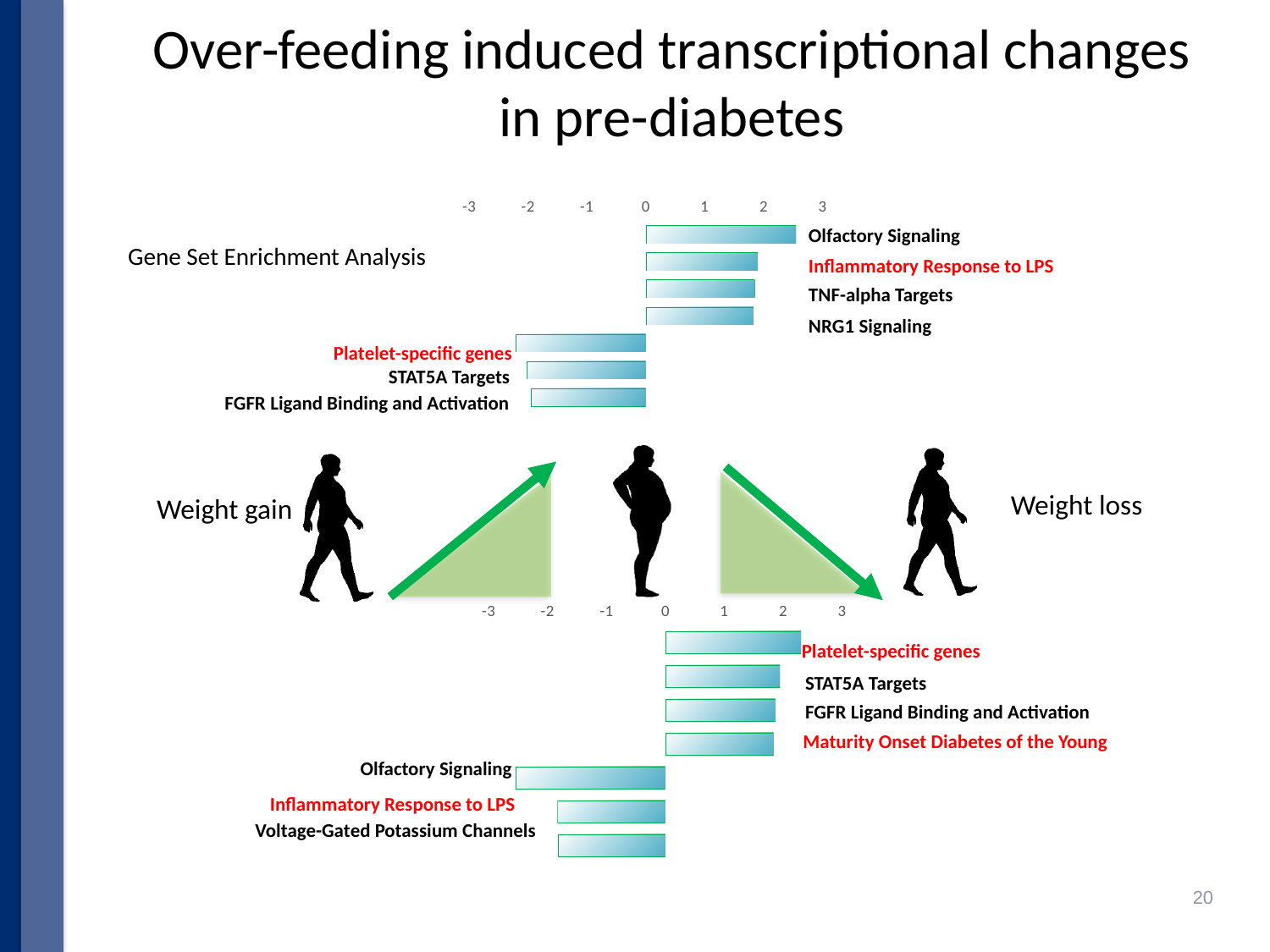
In the top chart (weight gain), which gene set has the highest positive value? Olfactory Signaling What kind of chart is the top chart under 'Gene Set Enrichment Analysis'? bar chart In the top chart (weight gain), is the value for Olfactory Signaling greater or less than 2? greater In the top chart (weight gain), is the value for TNF-alpha Targets greater or less than 2? less In the top chart (weight gain), how many gene sets are plotted? 7 In the top chart (weight gain), which is larger, the value for Olfactory Signaling or the value for NRG1 Signaling? Olfactory Signaling In the bottom chart (weight loss), which gene set has the highest positive value? Platelet-specific genes In the bottom chart (weight loss), which gene set has the lowest (most negative) value? Olfactory Signaling In the bottom chart (weight loss), is the value for Olfactory Signaling greater or less than -2? less In the bottom chart (weight loss), which is larger, the value for Platelet-specific genes or the value for Maturity Onset Diabetes of the Young? Platelet-specific genes In the bottom chart (weight loss), how many gene sets are plotted? 7 What is the title of the slide containing the two bar charts? Over-feeding induced transcriptional changes in pre-diabetes